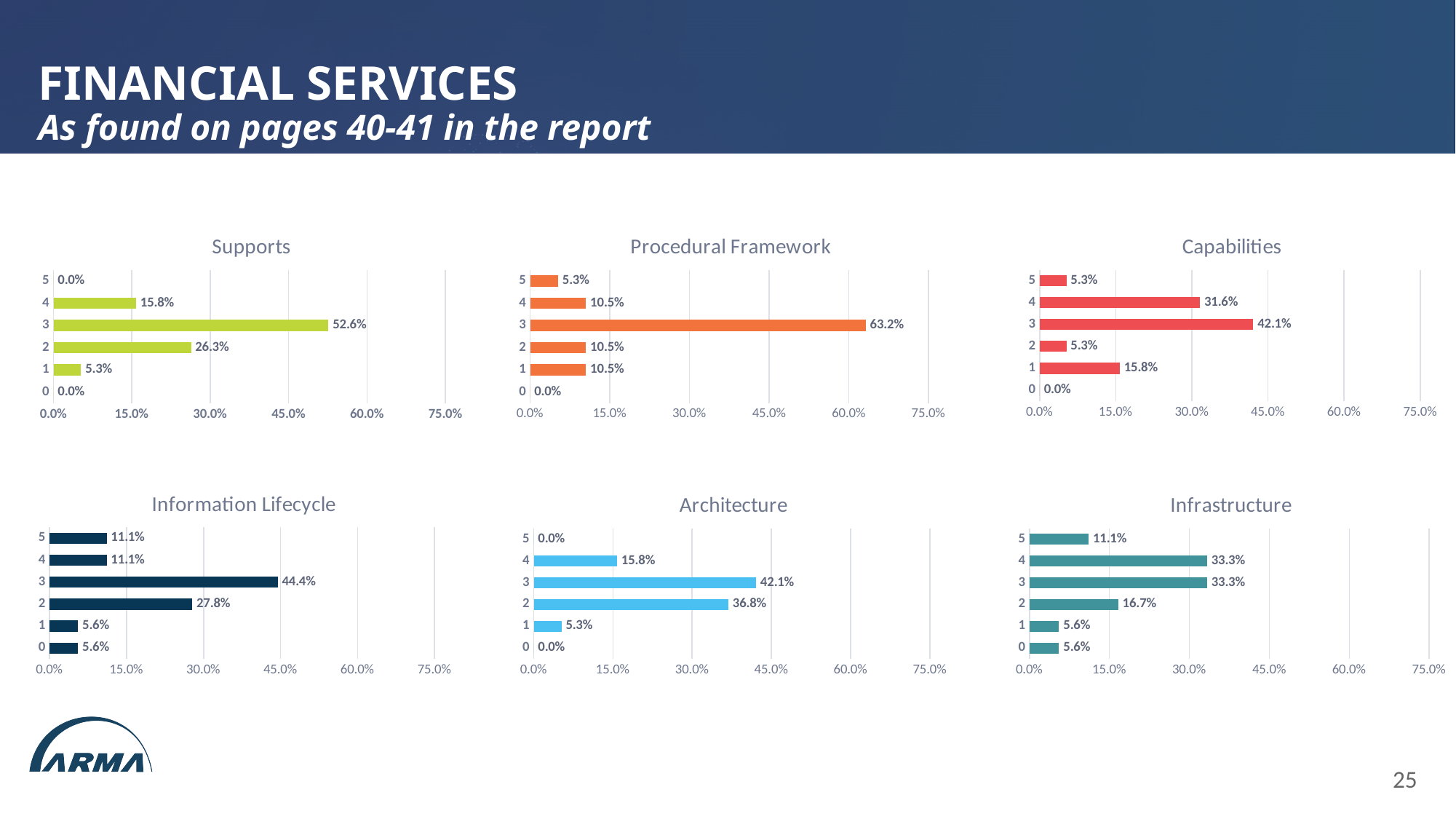
In the Information Lifecycle chart, which category has the highest value? 3 In the Procedural Framework chart, which category has the highest value? 3 In the Supports chart, what is the value for category 3? 52.6% In the Capabilities chart, what is the value for category 4? 31.6% How many categories are shown in the Supports chart? 6 How many charts are shown on the slide? 6 In the Architecture chart, which is larger, the value for category 3 or category 2? Category 3 In the Architecture chart, what is the value for category 4? 15.8% In the Infrastructure chart, what is the value for category 2? 16.7% In the Procedural Framework chart, is the value for category 3 greater or less than 60.0%? greater In the Information Lifecycle chart, what is the difference between the values for category 3 and category 2? 16.6% What kind of chart is the Capabilities chart? Bar chart